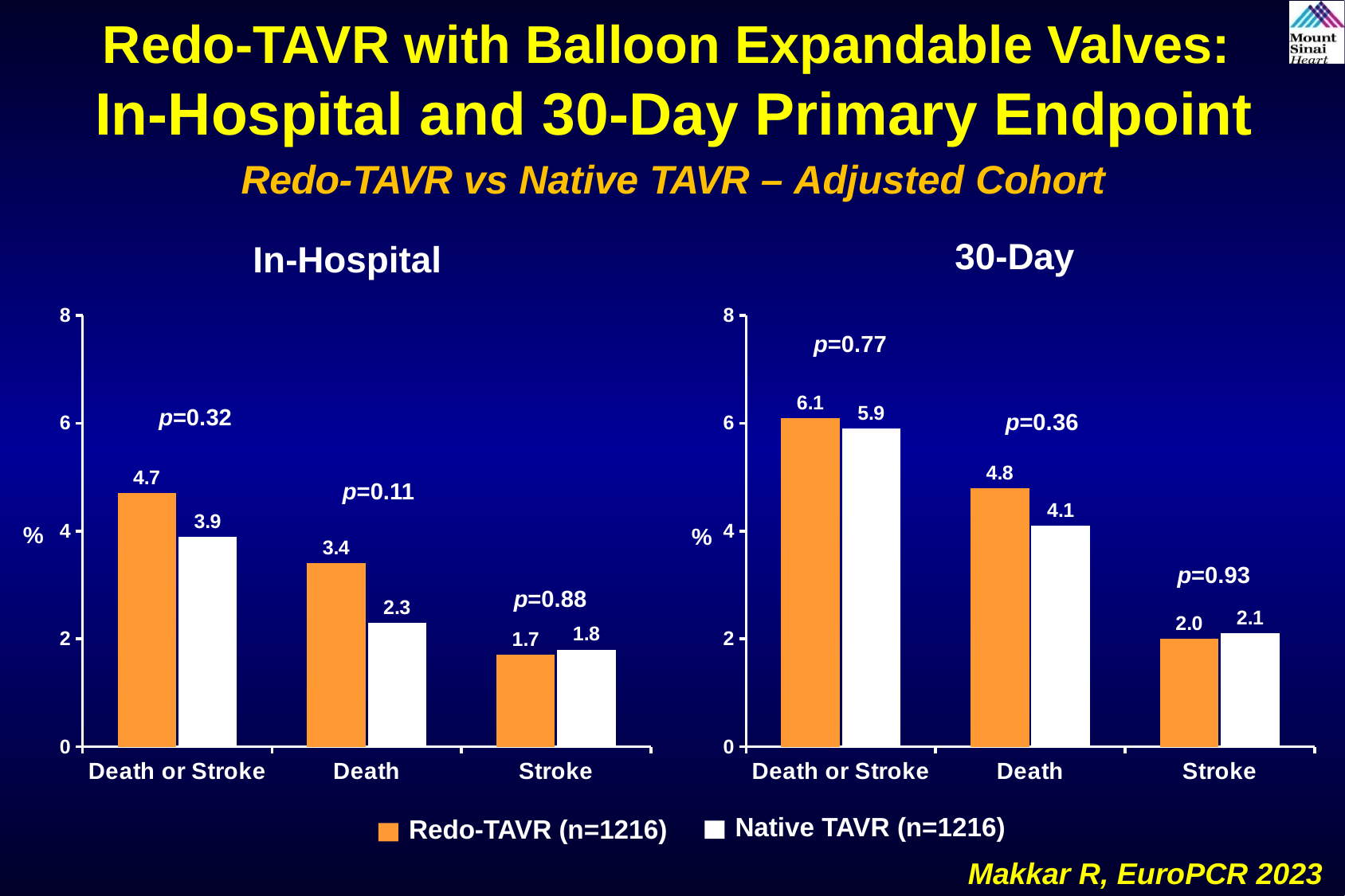
How many series does the legend list? 2 In the In-Hospital chart, which category has the lowest Native TAVR value? Stroke In the 30-Day chart, which category has the highest Redo-TAVR value? Death or Stroke In the 30-Day chart, what is the difference between the Redo-TAVR and Native TAVR values for Death or Stroke? 0.2 In the In-Hospital chart, what is the value for Redo-TAVR for Death or Stroke? 4.7 In the 30-Day chart, which is larger for Stroke: Redo-TAVR or Native TAVR? Native TAVR In the 30-Day chart, what p-value is shown for Death? p=0.36 In the 30-Day chart, what is the value for Native TAVR for Death? 4.1 In the In-Hospital chart, what is the difference between the Redo-TAVR and Native TAVR values for Death? 1.1 In the In-Hospital chart, how many categories are shown on the x axis? 3 What kind of chart is the 30-Day chart? Bar chart In the In-Hospital chart, what is the value for Native TAVR for Stroke? 1.8